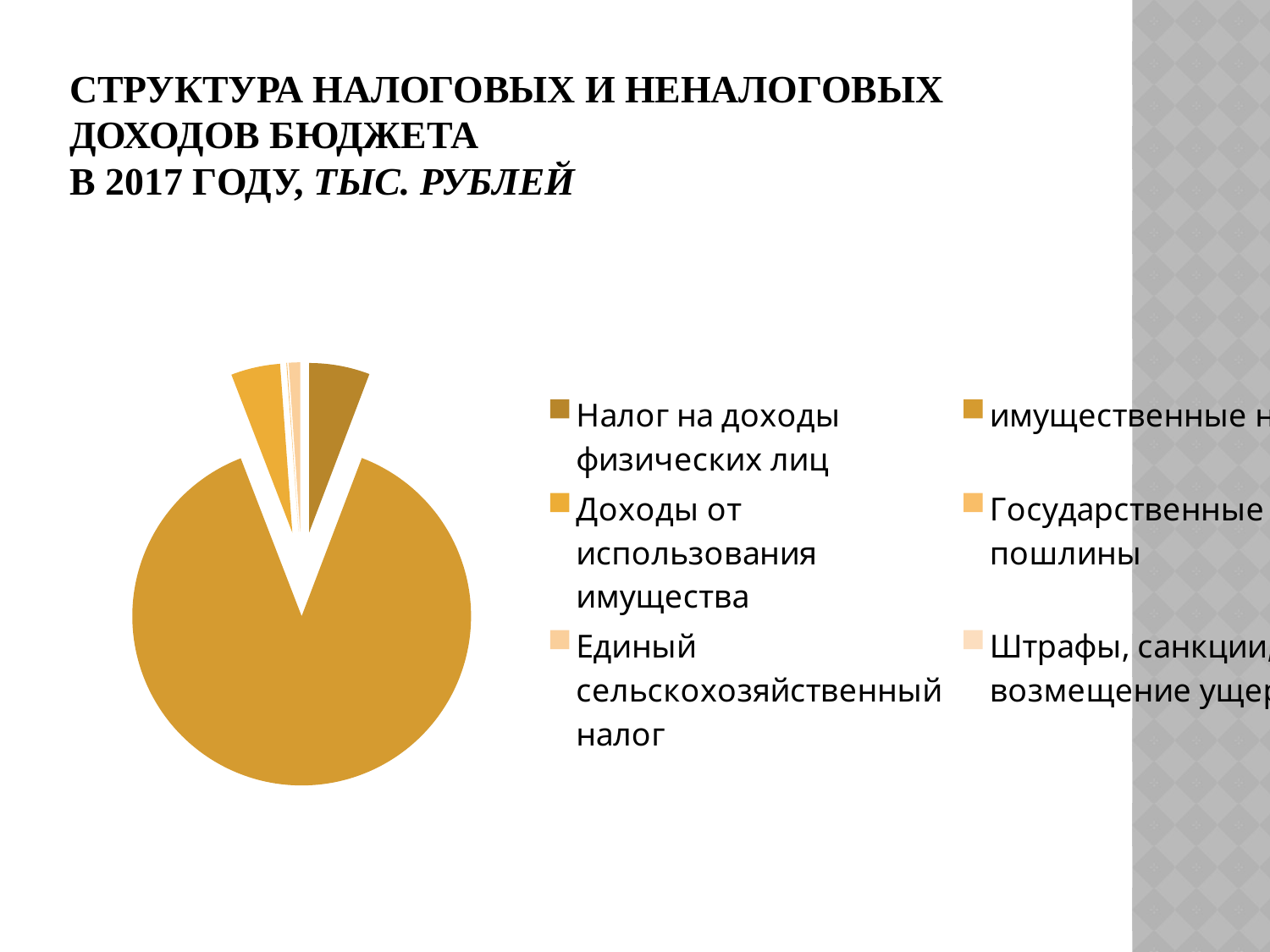
Which is larger in the pie chart: the slice for Налог на доходы физических лиц or the slice for Единый сельскохозяйственный налог? Налог на доходы физических лиц Does the slice for Доходы от использования имущества make up more or less than half of the pie? less In what units does the chart title say the values are given? тыс. рублей What year does the chart title say the budget revenue structure refers to? 2017 How many entries does the legend of the pie chart list? 6 Which is larger in the pie chart: the slice for Доходы от использования имущества or the slice for Налог на доходы физических лиц? Налог на доходы физических лиц What kind of chart is shown on the slide? pie chart